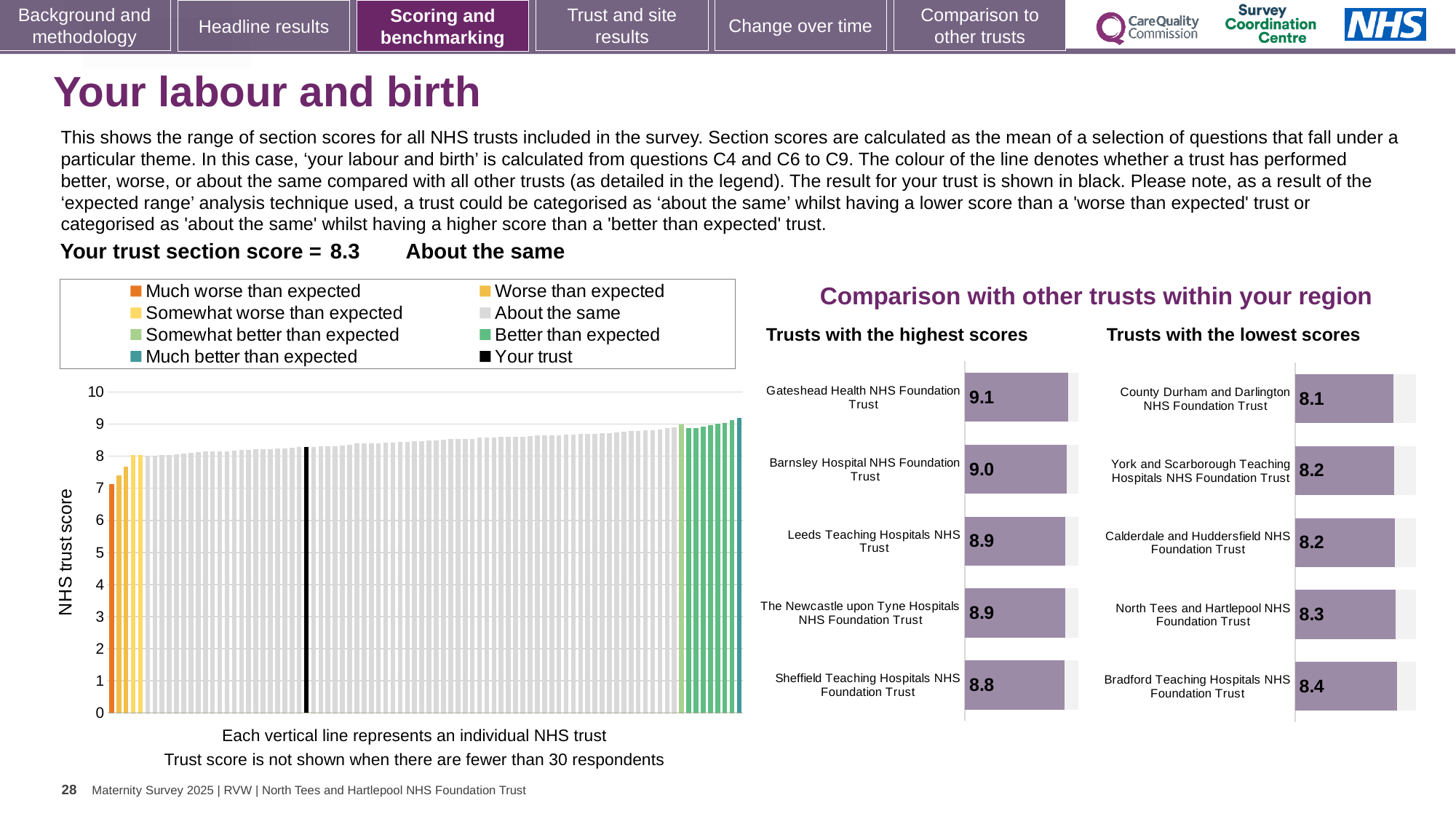
In the 'Trusts with the lowest scores' chart, what is the score for County Durham and Darlington NHS Foundation Trust? 8.1 In the 'Trusts with the highest scores' chart, what is the score for Sheffield Teaching Hospitals NHS Foundation Trust? 8.8 In the large chart on the left, do the NHS trust scores rise or fall from left to right? Rise In the 'Trusts with the highest scores' chart, what is the score for Gateshead Health NHS Foundation Trust? 9.1 What kind of chart is the large chart on the left showing NHS trust scores? Bar chart In the 'Trusts with the lowest scores' chart, which has the larger score: North Tees and Hartlepool NHS Foundation Trust or County Durham and Darlington NHS Foundation Trust? North Tees and Hartlepool NHS Foundation Trust In the 'Trusts with the highest scores' chart, what is the difference between the scores of Gateshead Health NHS Foundation Trust and Sheffield Teaching Hospitals NHS Foundation Trust? 0.3 In the 'Trusts with the highest scores' chart, which trust has the highest score? Gateshead Health NHS Foundation Trust How many trusts are listed in the 'Trusts with the lowest scores' chart? 5 In the 'Trusts with the lowest scores' chart, which trust has the lowest score? County Durham and Darlington NHS Foundation Trust How many entries does the legend of the large chart on the left list? 8 In the 'Trusts with the lowest scores' chart, which trust has the highest score? Bradford Teaching Hospitals NHS Foundation Trust